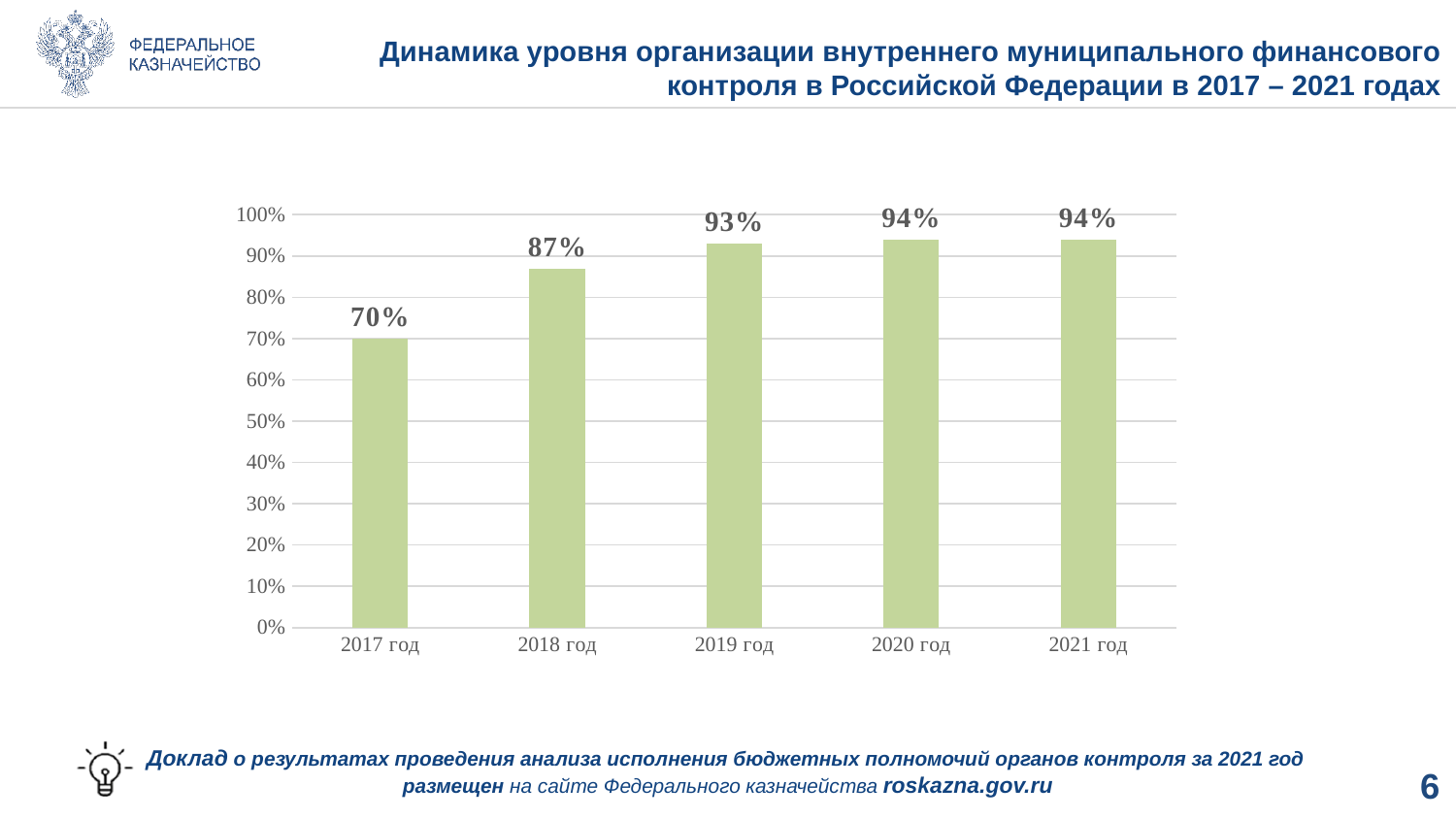
What is the difference between the values for 2020 год and 2019 год? 1% What kind of chart is shown on the slide? bar chart What is the value for 2019 год? 93% What is the value for 2021 год? 94% What is the difference between the values for 2018 год and 2017 год? 17% Which is larger, the value for 2018 год or the value for 2019 год? 2019 год What is the value for 2017 год? 70% Which year has the lowest value? 2017 год How many years are shown on the x axis? 5 Is the value for 2018 год greater or less than 80%? greater Do the values rise or fall from 2017 год to 2021 год? rise What is the highest tick shown on the y axis? 100%